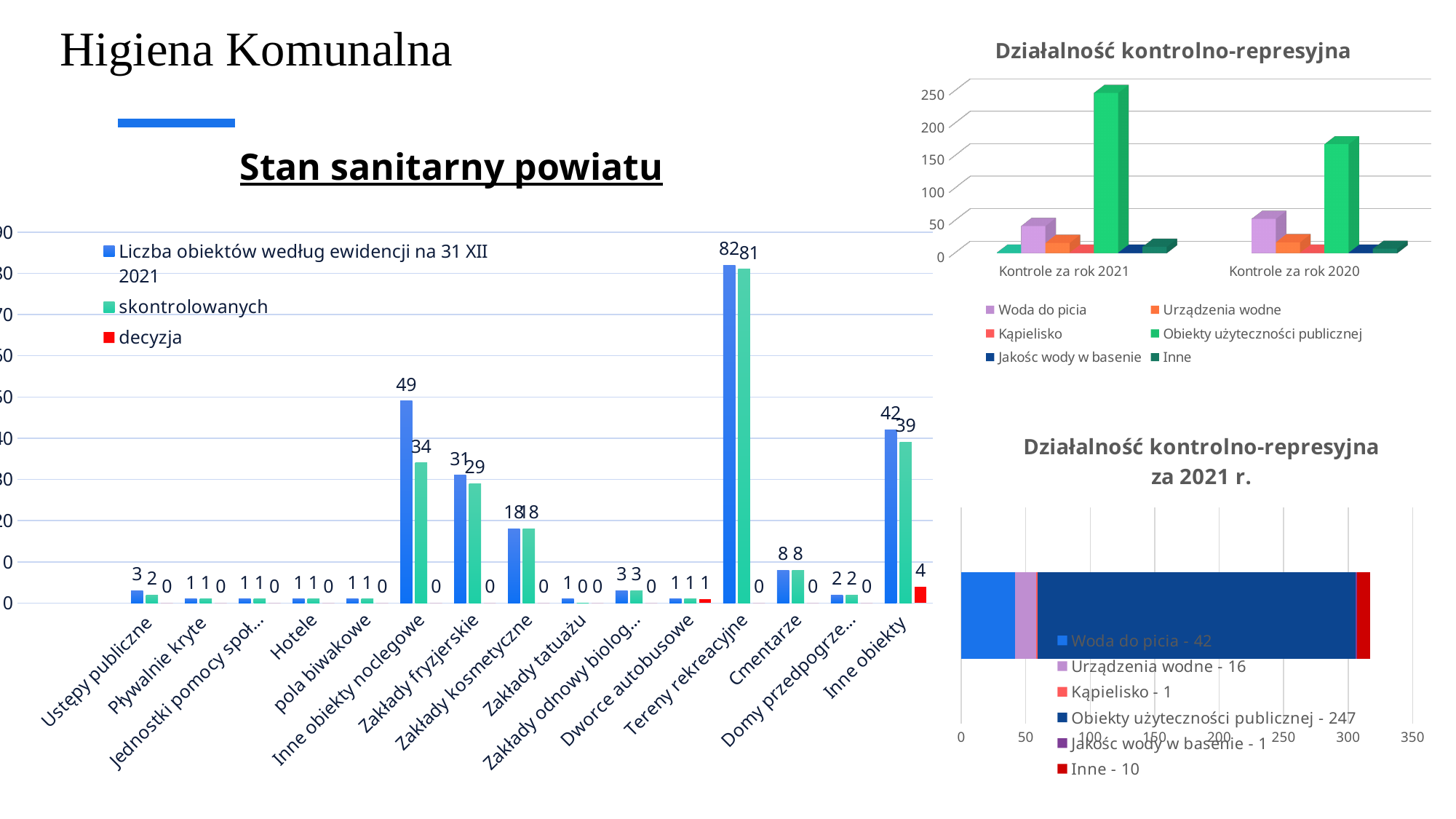
In the 'Stan sanitarny powiatu' chart, what is the value of 'Liczba obiektów według ewidencji na 31 XII 2021' for Tereny rekreacyjne? 82 In the 'Stan sanitarny powiatu' chart, which category has the highest 'Liczba obiektów według ewidencji na 31 XII 2021' value? Tereny rekreacyjne In the 'Stan sanitarny powiatu' chart, what is the 'skontrolowanych' value for Inne obiekty noclegowe? 34 In the 'Stan sanitarny powiatu' chart, what is the 'decyzja' value for Inne obiekty? 4 In the 'Stan sanitarny powiatu' chart, what is the difference between the 'Liczba obiektów według ewidencji' and 'skontrolowanych' values for Inne obiekty noclegowe? 15 How many series does the legend of the 'Stan sanitarny powiatu' chart list? 3 How many series does the legend of the 'Działalność kontrolno-represyjna' chart at the top right list? 6 In the 'Działalność kontrolno-represyjna' chart at the top right, is the value for Obiekty użyteczności publicznej in 'Kontrole za rok 2020' greater or less than 200? less In the 'Stan sanitarny powiatu' chart, which is larger: the 'skontrolowanych' value for Zakłady fryzjerskie or for Inne obiekty? Inne obiekty In the 'Działalność kontrolno-represyjna' chart at the top right, is the value for Obiekty użyteczności publicznej in 'Kontrole za rok 2021' greater or less than 200? greater In the 'Działalność kontrolno-represyjna za 2021 r.' chart, what is the total of all segments in the stacked bar? 317 In the 'Działalność kontrolno-represyjna za 2021 r.' chart, what is the value for Obiekty użyteczności publicznej? 247